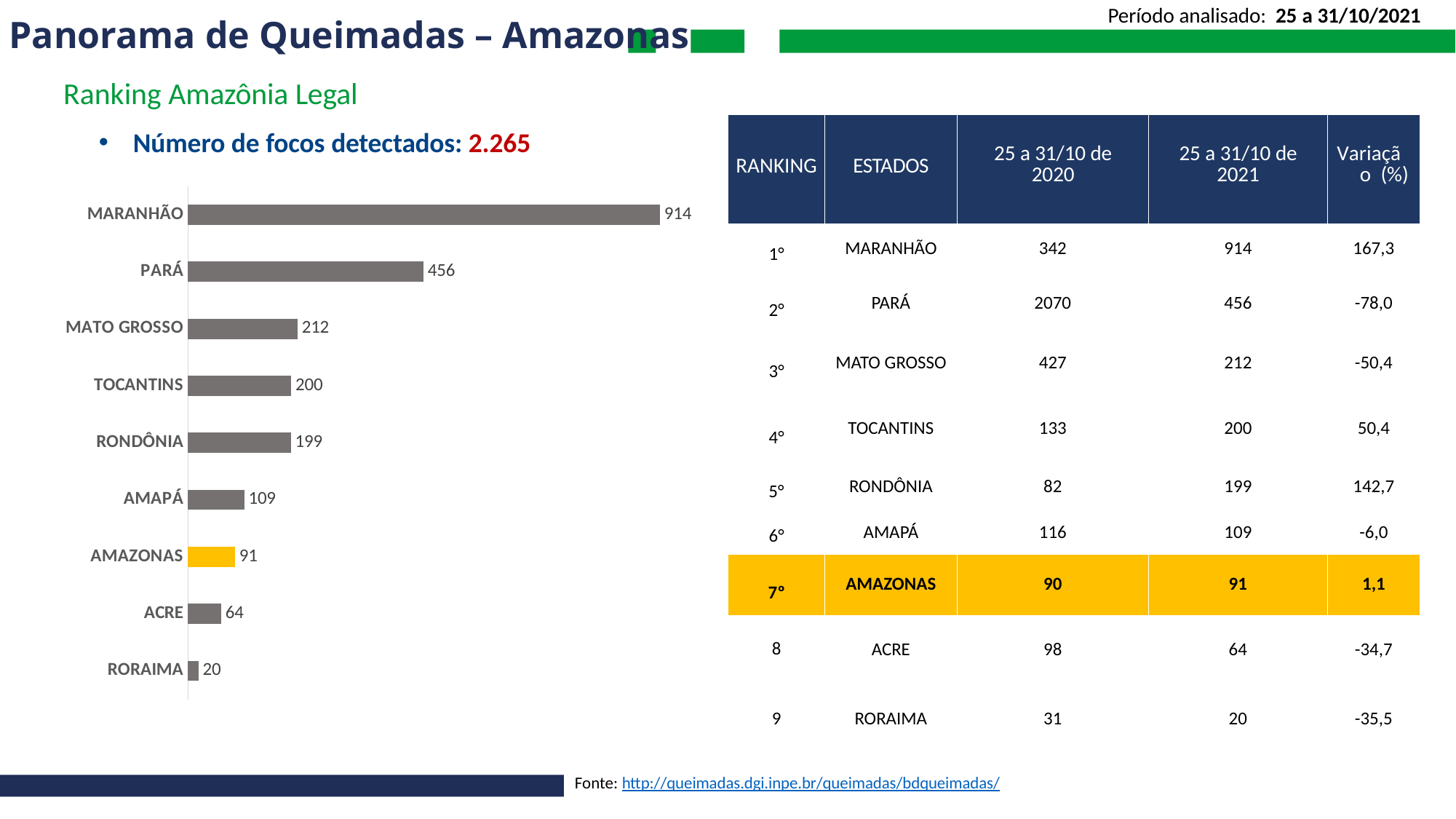
Which has a larger value in the bar chart, AMAZONAS or ACRE? AMAZONAS What is the difference between the values for MARANHÃO and PARÁ in the bar chart? 458 Which state has the highest value in the bar chart? MARANHÃO What is the value for AMAZONAS in the bar chart? 91 Which state has the lowest value in the bar chart? RORAIMA Which has a larger value in the bar chart, PARÁ or MATO GROSSO? PARÁ What is the value for MARANHÃO in the bar chart? 914 What kind of chart is shown on the slide? Bar chart How many states are shown in the bar chart? 9 What is the difference between the values for AMAPÁ and ACRE in the bar chart? 45 Which state's bar is highlighted in yellow in the bar chart? AMAZONAS What is the value for TOCANTINS in the bar chart? 200